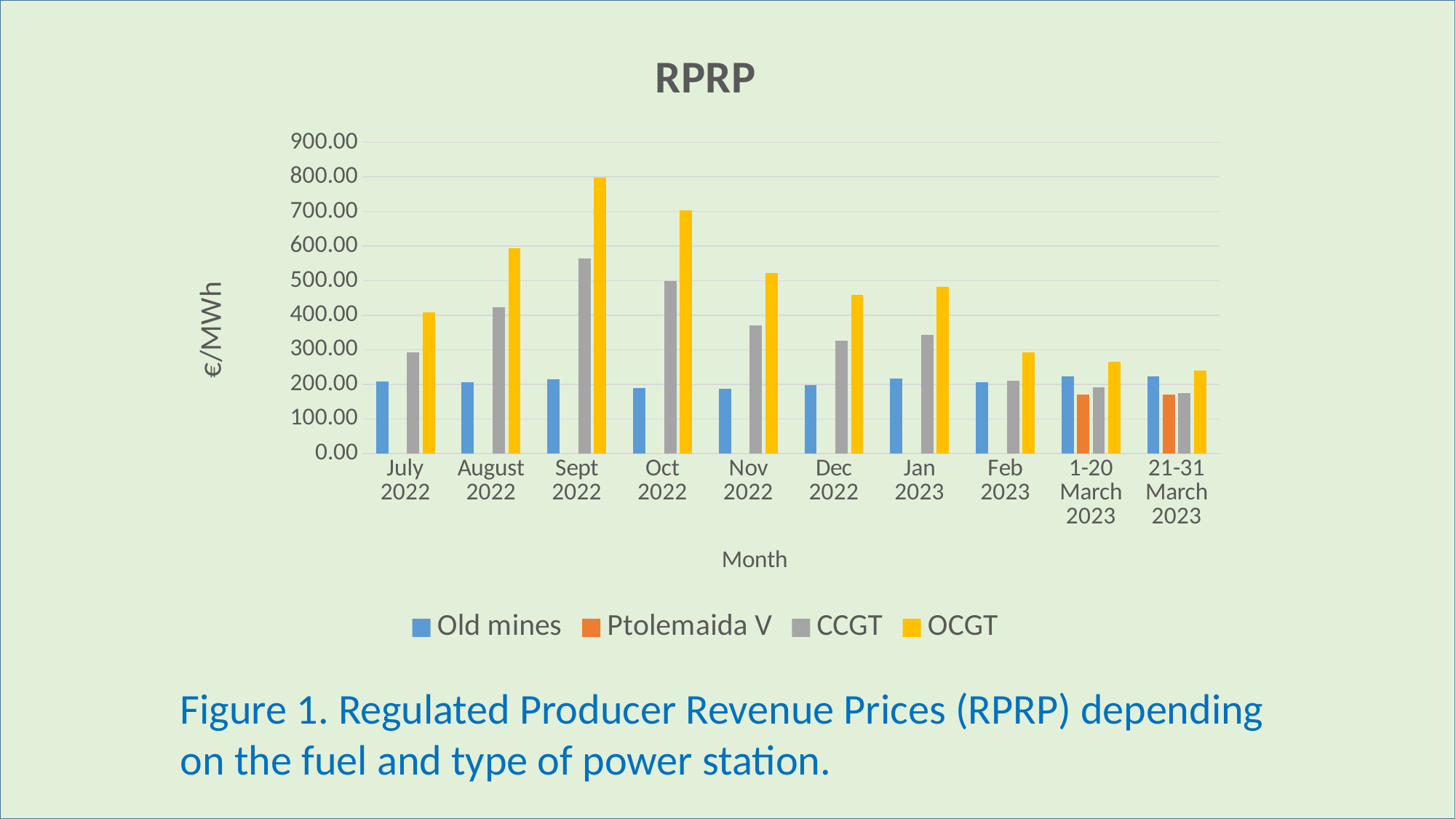
Which period has the highest OCGT value? Sept 2022 What kind of chart is shown on the slide? bar chart What is the title of the chart? RPRP Which period has the lowest OCGT value? 21-31 March 2023 Is the Old mines value for Nov 2022 greater or less than 200.00? less Is the OCGT value for Oct 2022 greater or less than 600.00? greater How many series does the legend list? 4 Do the OCGT values rise or fall from Sept 2022 to 21-31 March 2023? fall Which is larger in Jan 2023, the CCGT value or the OCGT value? OCGT Is the CCGT value for August 2022 greater or less than 400.00? greater Which period has the highest CCGT value? Sept 2022 How many time periods are shown on the x axis? 10